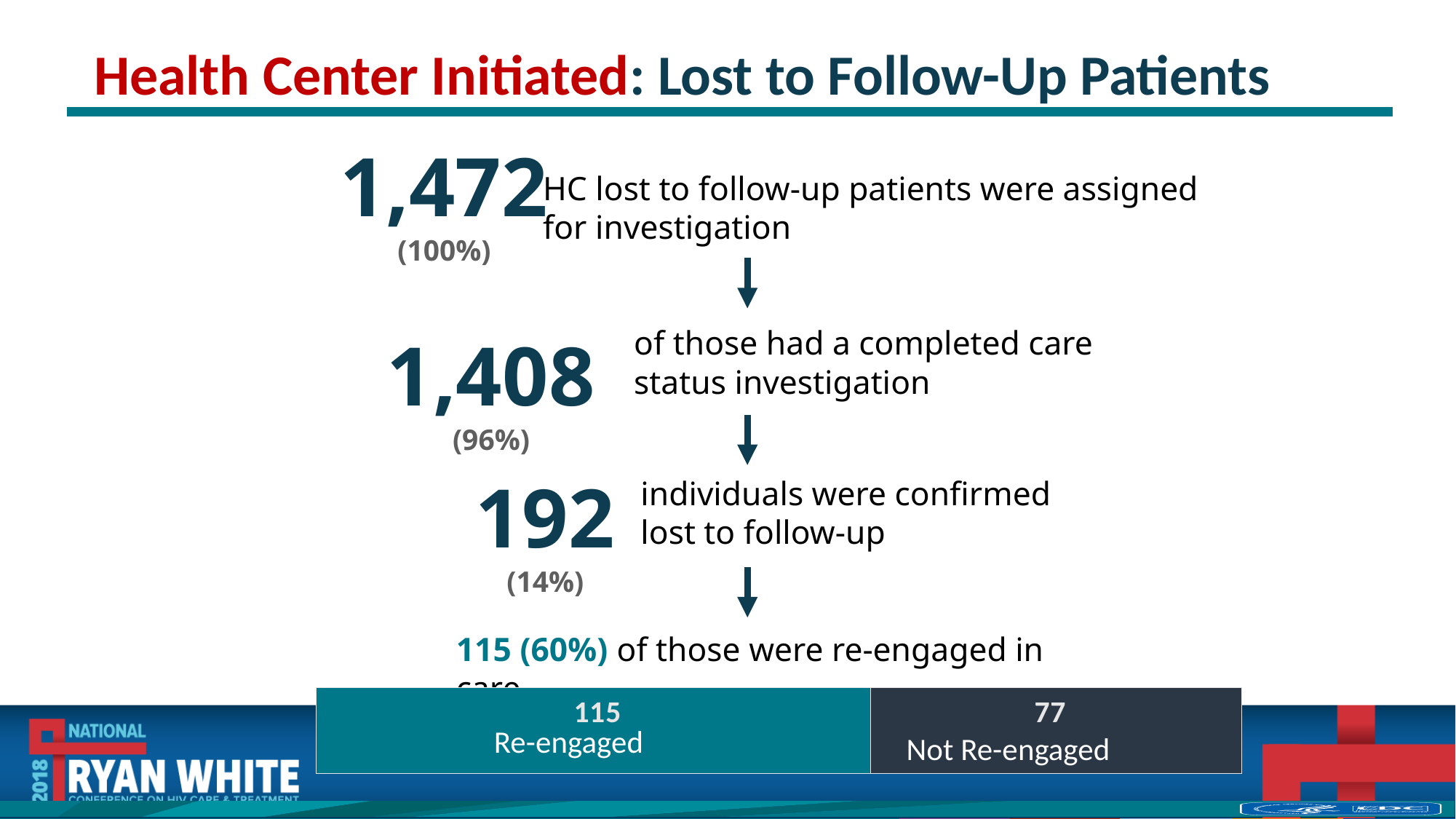
What is the difference between the Re-engaged and Not Re-engaged counts in the bottom bar? 38 In the bar at the bottom of the slide, how many patients are labelled as Re-engaged? 115 What is the total of the two segments in the bottom bar? 192 Which segment of the bottom bar is the smallest? Not Re-engaged Which segment of the bottom bar is larger, Re-engaged or Not Re-engaged? Re-engaged How many segments does the bottom bar have? 2 What kind of chart is shown at the bottom of the slide? Stacked bar chart What colour is the Re-engaged segment of the bottom bar? Teal What is the title of the slide containing the bar chart? Health Center Initiated: Lost to Follow-Up Patients In the bar at the bottom of the slide, how many patients are labelled as Not Re-engaged? 77 What share of the confirmed lost-to-follow-up individuals were re-engaged in care, as printed on the slide? 60%